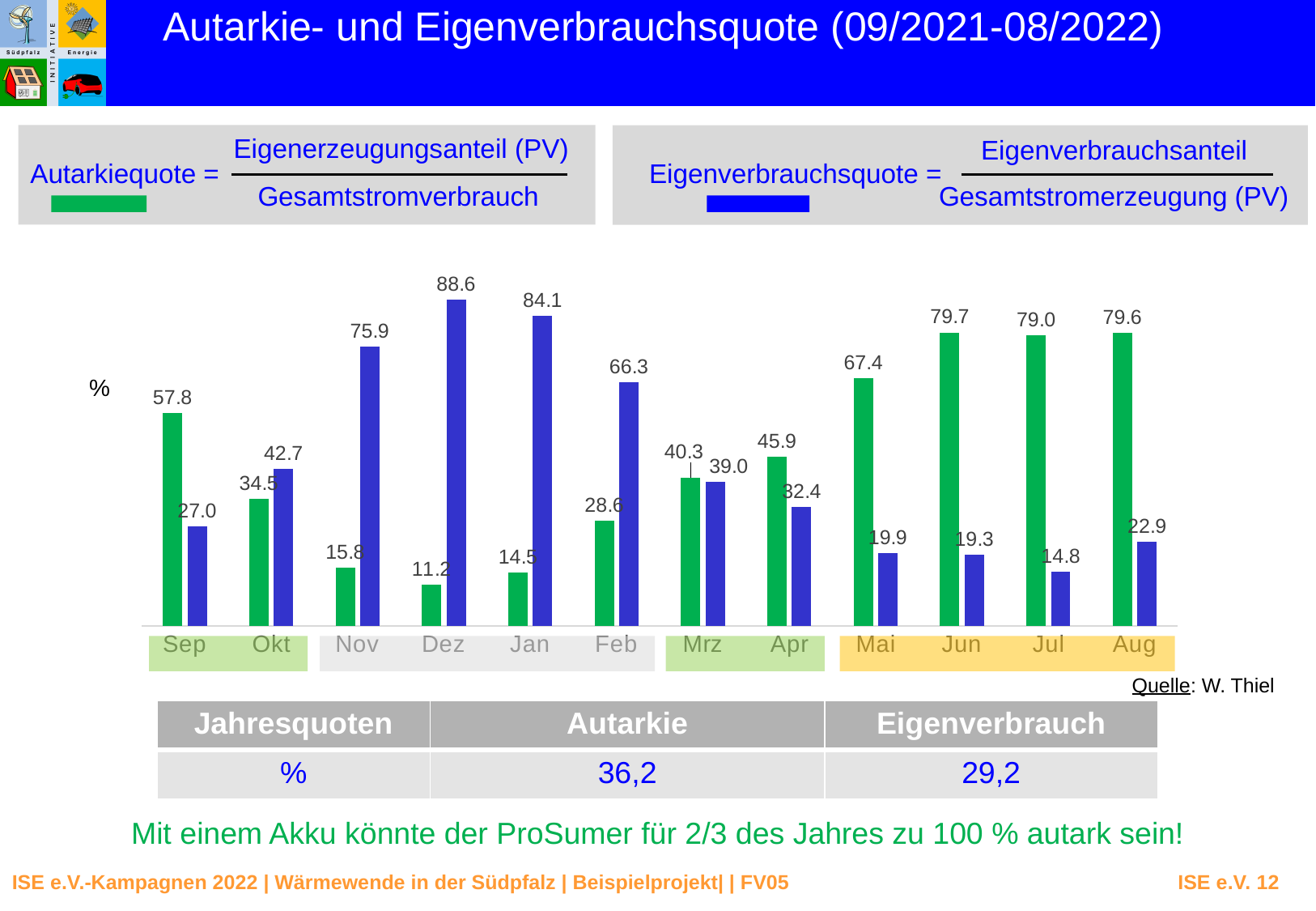
What type of chart is shown on the slide? bar chart In which month is the green bar (Autarkiequote) lowest? Dez What is the difference between the blue bar and the green bar in Nov? 60.1 What is the value of the green bar for Mai? 67.4 How many months are shown on the x axis? 12 What is the value of the blue bar for Jul? 14.8 What is the Autarkiequote (green bar) for Dez? 11.2 In which month is the blue bar (Eigenverbrauchsquote) highest? Dez Which colour represents the Autarkiequote in the chart? green Which is larger in Okt, the green bar or the blue bar? the blue bar What is the Eigenverbrauchsquote (blue bar) for Jan? 84.1 How many data series (bar colours) are plotted in the chart? 2